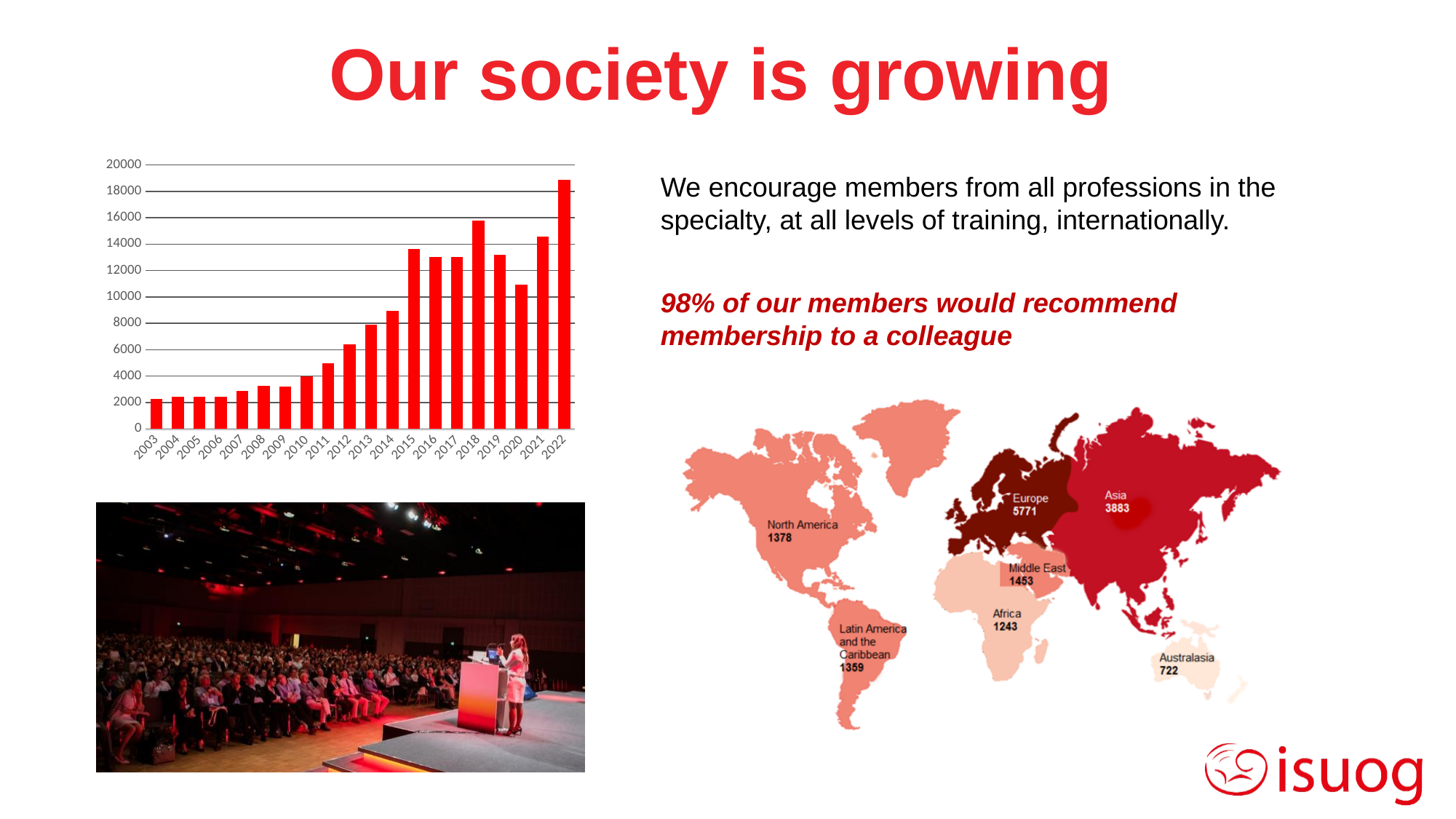
On the bar chart at the left, what kind of chart is shown? bar chart On the bar chart at the left, is the value for 2010 greater or less than 6000? less On the world map at the right, what is the difference between the values for Europe and Asia? 1888 On the bar chart at the left, do the values generally rise or fall from 2003 to 2022? rise On the world map at the right, how many regions have a value labelled? 7 On the bar chart at the left, which year has the larger value, 2018 or 2019? 2018 On the world map at the right, what is the value shown for Europe? 5771 On the bar chart at the left, is the value for 2020 greater or less than 12000? less On the world map at the right, which region has the lowest value? Australasia On the bar chart at the left, how many years are plotted along the x axis? 20 On the bar chart at the left, which year has the highest bar? 2022 On the bar chart at the left, is the value for 2022 greater or less than 18000? greater